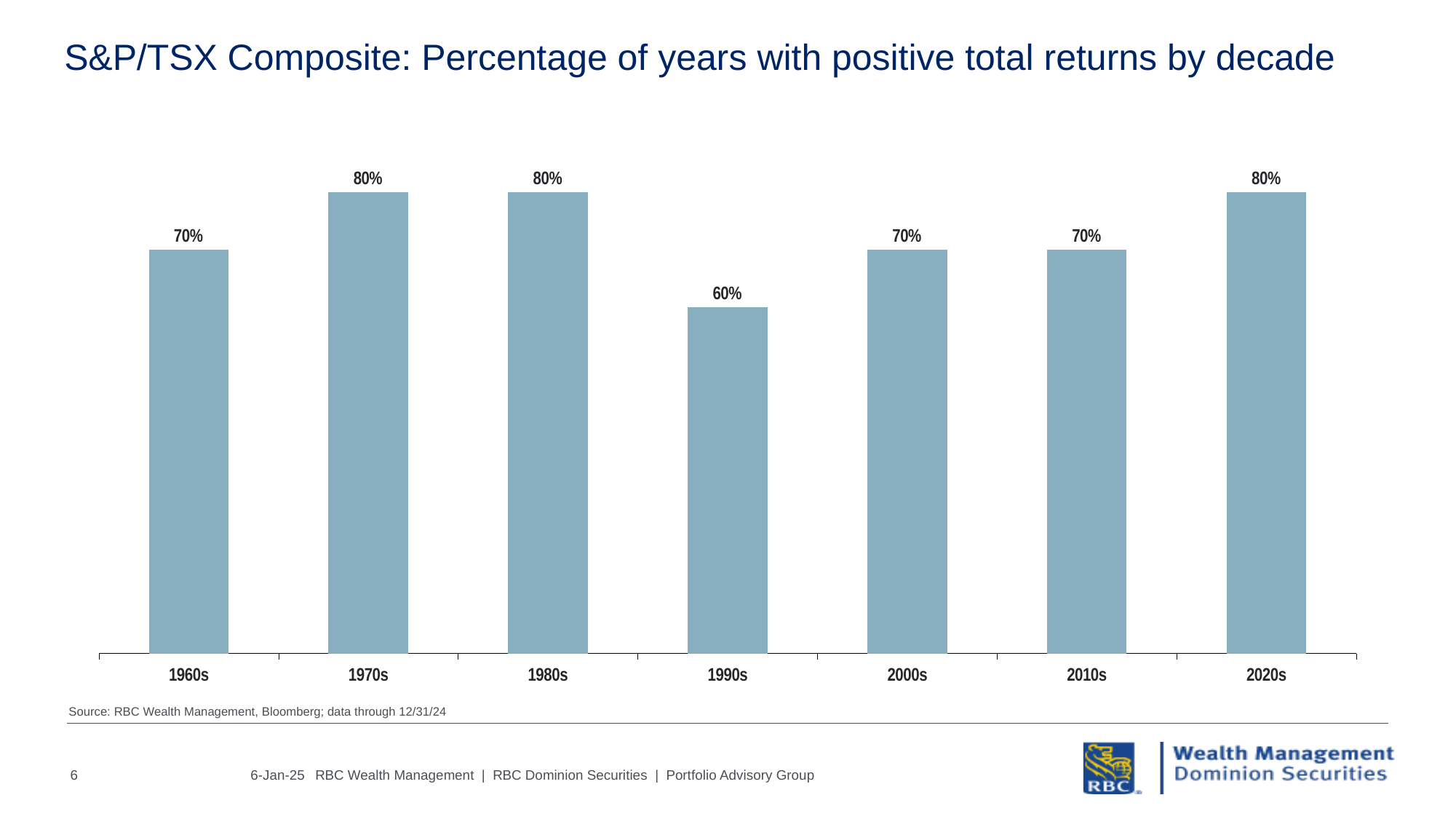
Which is larger, the value for the 1990s or the value for the 1960s? 1960s What is the difference between the values for the 1980s and the 1990s? 20% What is the difference between the values for the 2020s and the 2010s? 10% What is the value shown for the 2020s? 80% Which decade has the lowest percentage of years with positive total returns? 1990s What is the title of the chart? S&P/TSX Composite: Percentage of years with positive total returns by decade What kind of chart is shown on the slide? Bar chart How many decades show a value of 80%? 3 What percentage of years had positive total returns in the 1990s? 60% Which is larger, the value for the 1970s or the value for the 2000s? 1970s What is the value shown for the 1960s? 70% How many decades are shown on the chart? 7